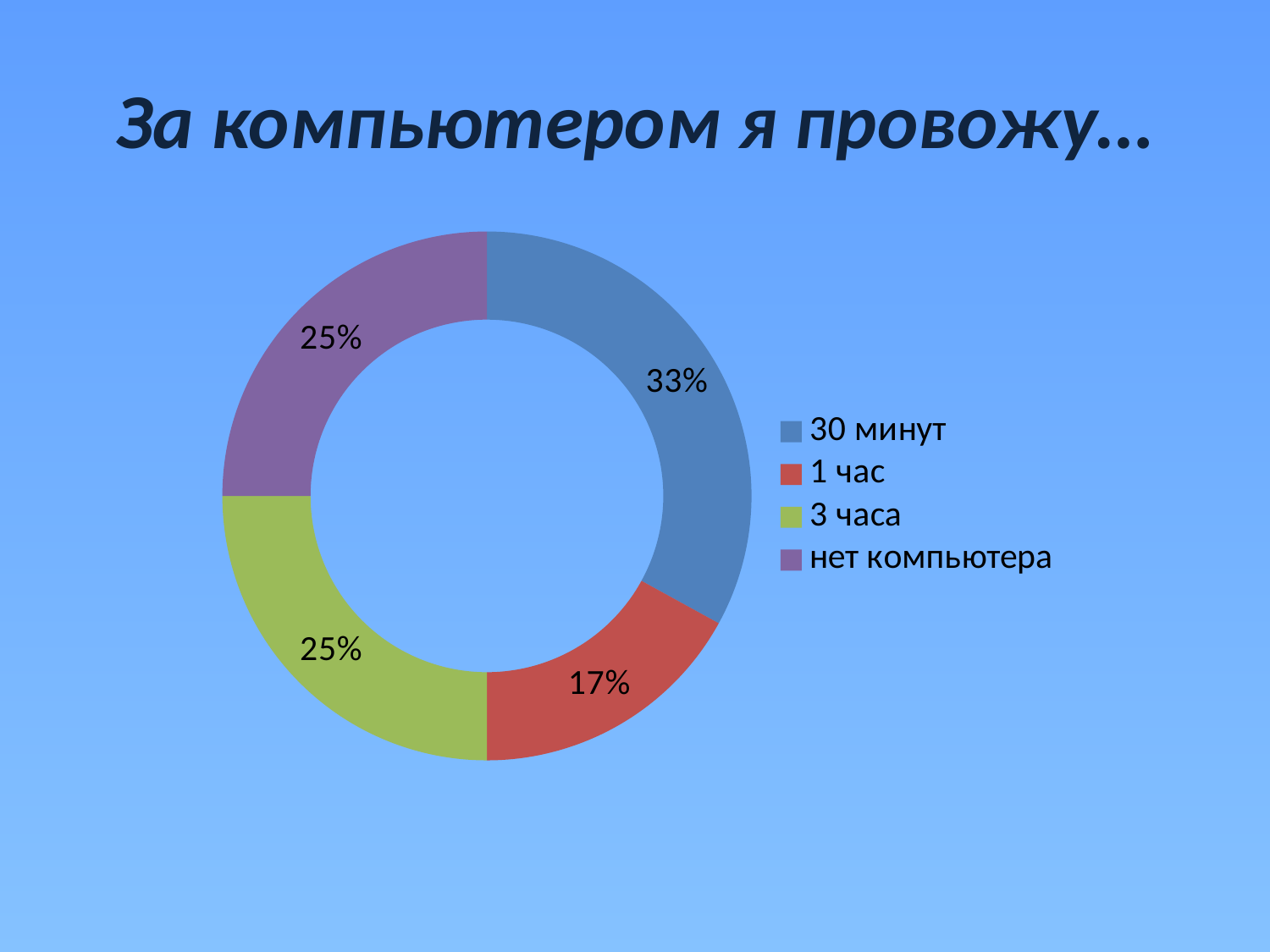
What colour is the "1 час" slice? Red What is the value shown for "3 часа"? 25% What share of the chart does the "30 минут" slice represent? 33% What is the value shown for "нет компьютера"? 25% What is the difference between the shares for "30 минут" and "1 час"? 16% How many categories does the chart show? 4 What kind of chart is shown on the slide? Doughnut (pie) chart What is the title of the slide? За компьютером я провожу… What is the value shown for "1 час"? 17% Which category has the largest share? 30 минут Which category has the smallest share? 1 час Which is larger, the share for "30 минут" or the share for "3 часа"? 30 минут